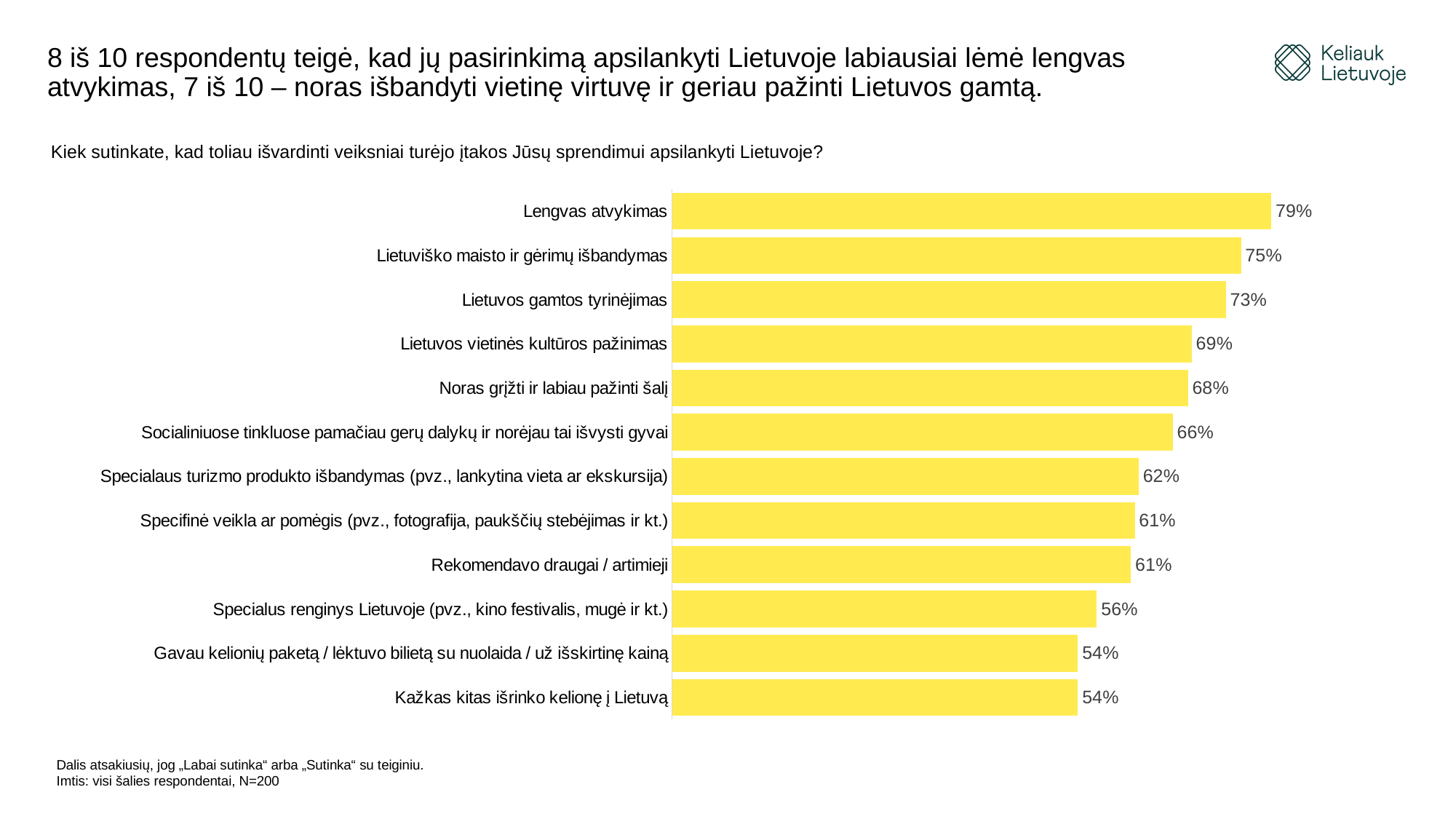
What is the difference between "Lietuvos vietinės kultūros pažinimas" and "Rekomendavo draugai / artimieji"? 8% What is the value for "Lengvas atvykimas"? 79% What is the value for "Socialiniuose tinkluose pamačiau gerų dalykų ir norėjau tai išvysti gyvai"? 66% How many categories are shown in the chart? 12 What is the value for "Specialus renginys Lietuvoje (pvz., kino festivalis, mugė ir kt.)"? 56% Which category has the highest value? Lengvas atvykimas What is the value for "Lietuvos gamtos tyrinėjimas"? 73% Which is larger: "Lietuvos gamtos tyrinėjimas" or "Noras grįžti ir labiau pažinti šalį"? Lietuvos gamtos tyrinėjimas What is the lowest value shown in the chart? 54% What kind of chart is shown on the slide? Bar chart What colour are the bars in the chart? Yellow What is the difference between "Lengvas atvykimas" and "Lietuviško maisto ir gėrimų išbandymas"? 4%